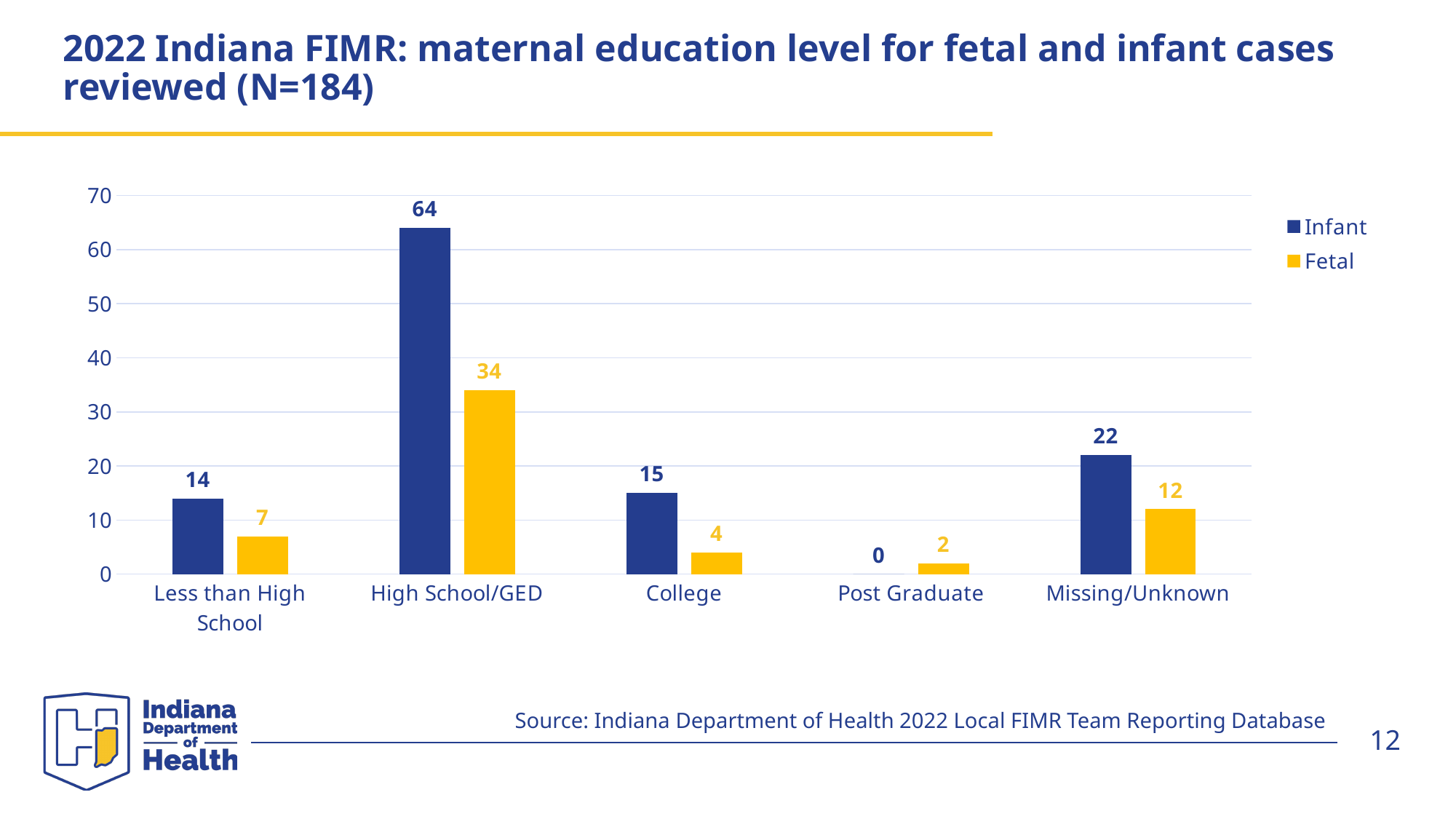
Which is larger for College: the Infant value or the Fetal value? Infant What kind of chart is shown on the slide? Bar chart What is the difference between the Infant and Fetal values for High School/GED? 30 Which education level has the lowest Infant value? Post Graduate Which colour represents the Fetal series? Yellow Is the Infant value for Missing/Unknown greater or less than 20? greater What is the Infant value for High School/GED? 64 What is the Infant value for Post Graduate? 0 How many education level categories are shown on the x axis? 5 Which education level has the highest Fetal value? High School/GED What is the Fetal value for Missing/Unknown? 12 How many series does the legend list? 2